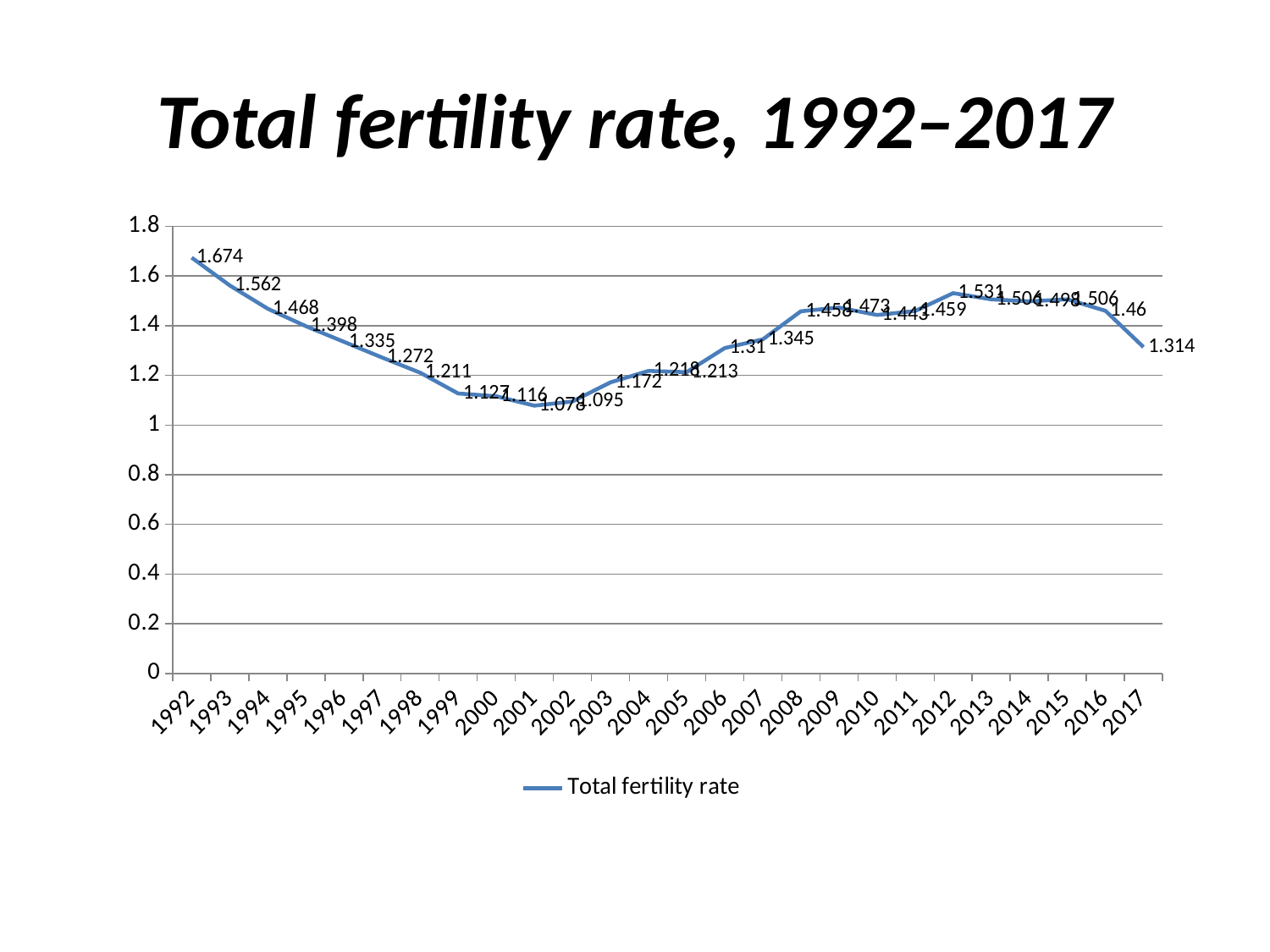
What is the total fertility rate in 1999? 1.127 What is the difference between the total fertility rate in 1992 and in 2017? 0.36 Does the total fertility rate rise or fall from 1992 to 2001? fall What is the total fertility rate in 1992? 1.674 Which year has the lowest total fertility rate? 2001 What is the total fertility rate in 2012? 1.531 Which year has a higher total fertility rate, 2006 or 2016? 2016 What is the total fertility rate in 2017? 1.314 Which year has the highest total fertility rate? 1992 How many years are plotted on the x axis? 26 How many series does the legend list? 1 What type of chart is shown on the slide? line chart